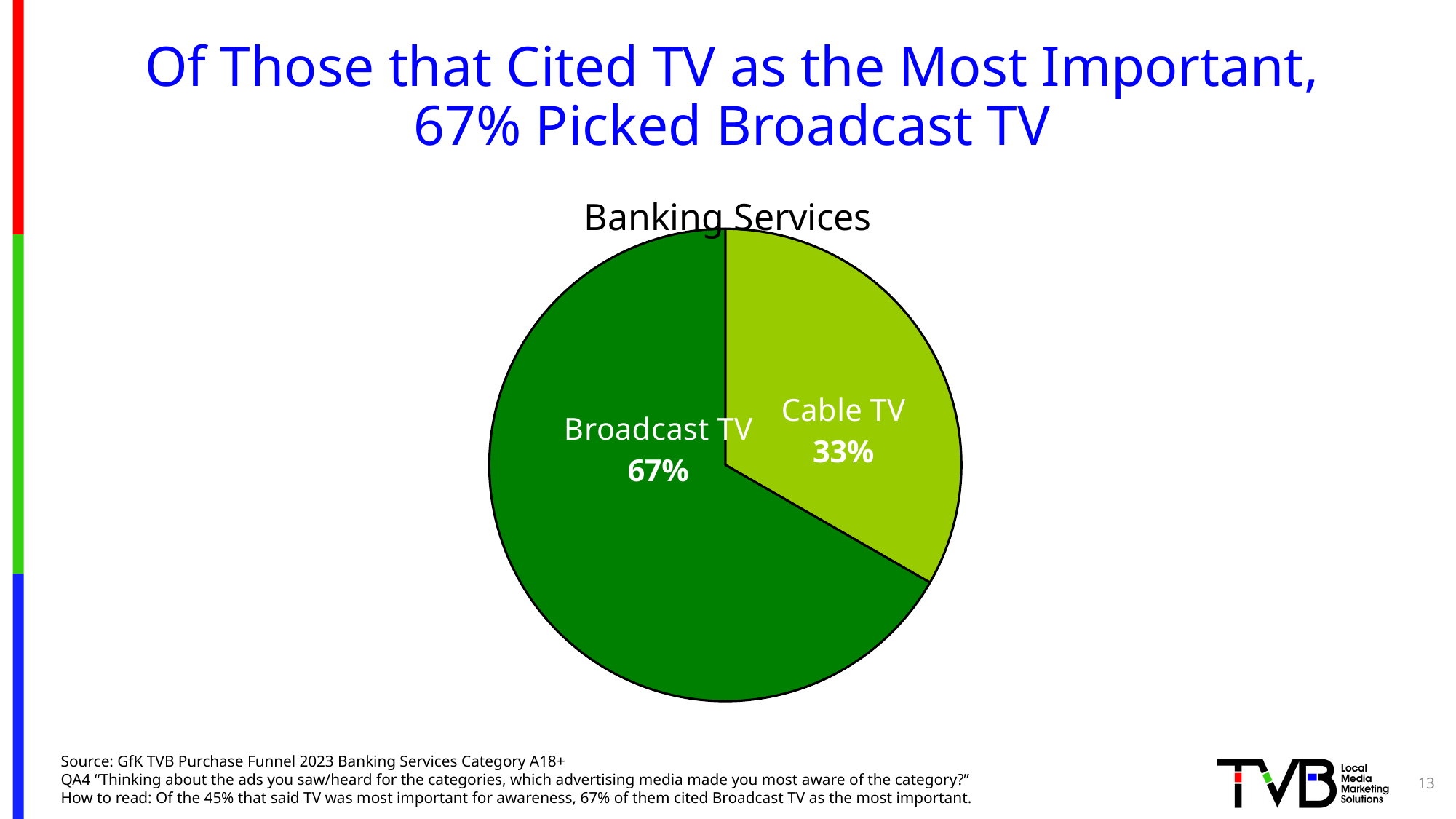
What is the difference in percentage points between the Broadcast TV and Cable TV slices? 34 What is the title of the chart? Banking Services Which slice of the pie is the smallest? Cable TV What share of the pie does Broadcast TV hold? 67% Which slice of the pie is the largest? Broadcast TV What colour is the Cable TV slice? Light green How many slices does the pie chart have? 2 Is the Cable TV share greater or less than 50%? less What share of the pie does Cable TV hold? 33% Which is larger, the Broadcast TV slice or the Cable TV slice? Broadcast TV What kind of chart is shown on the slide? Pie chart